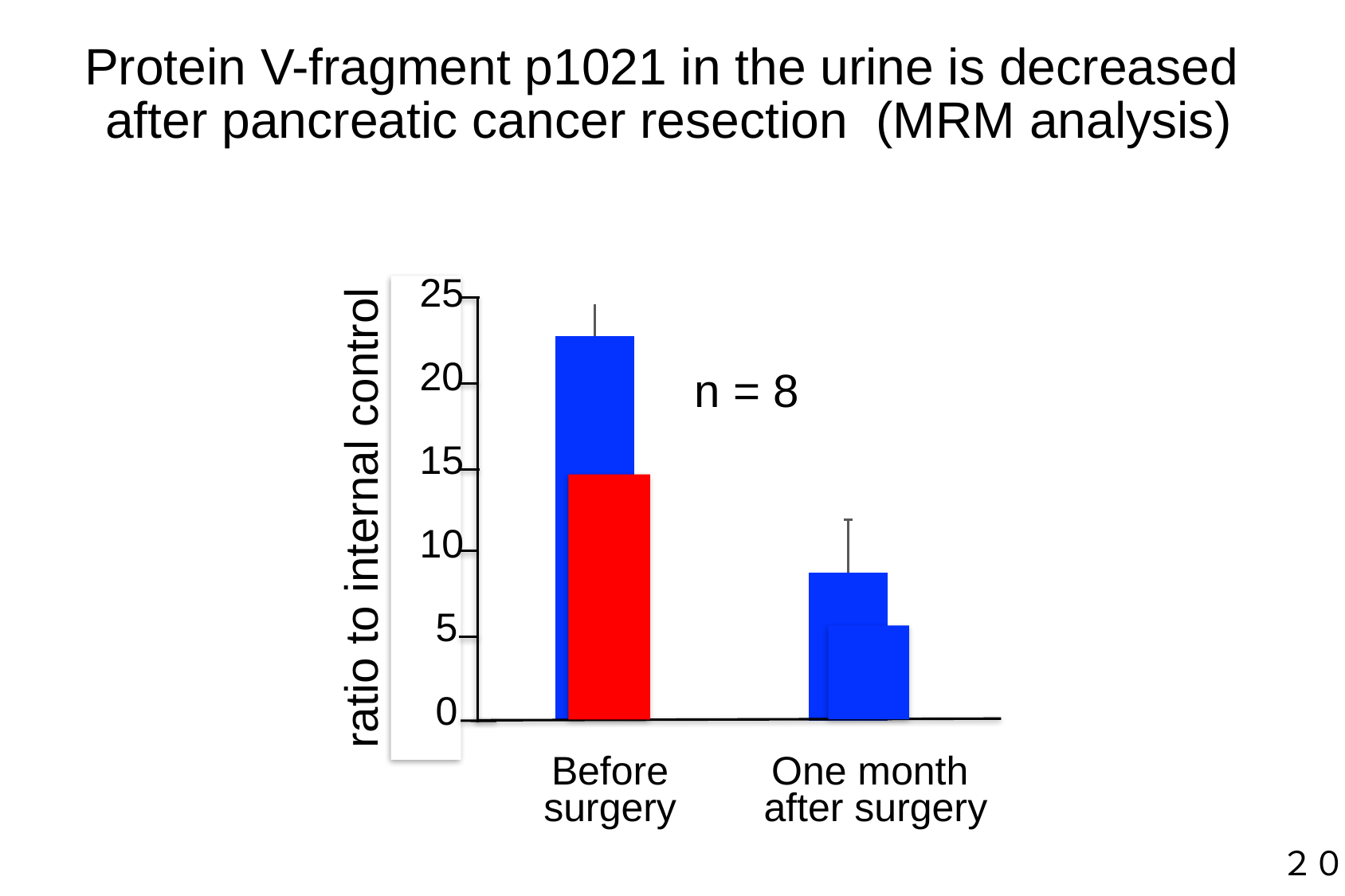
Do the bar values rise or fall from Before surgery to One month after surgery? fall What sample size is annotated on the chart? n = 8 Which category has the lowest bar in the chart? One month after surgery Is the tall blue bar for One month after surgery greater or less than 5? greater Which category has the highest bar in the chart? Before surgery How many categories are shown on the x axis of the chart? 2 What is the label of the y axis of the chart? ratio to internal control Is the tall blue bar for Before surgery greater or less than 20? greater Which is larger, the tall blue bar for Before surgery or the tall blue bar for One month after surgery? Before surgery Is the red bar for Before surgery greater or less than 10? greater What kind of chart is shown on the slide? bar chart